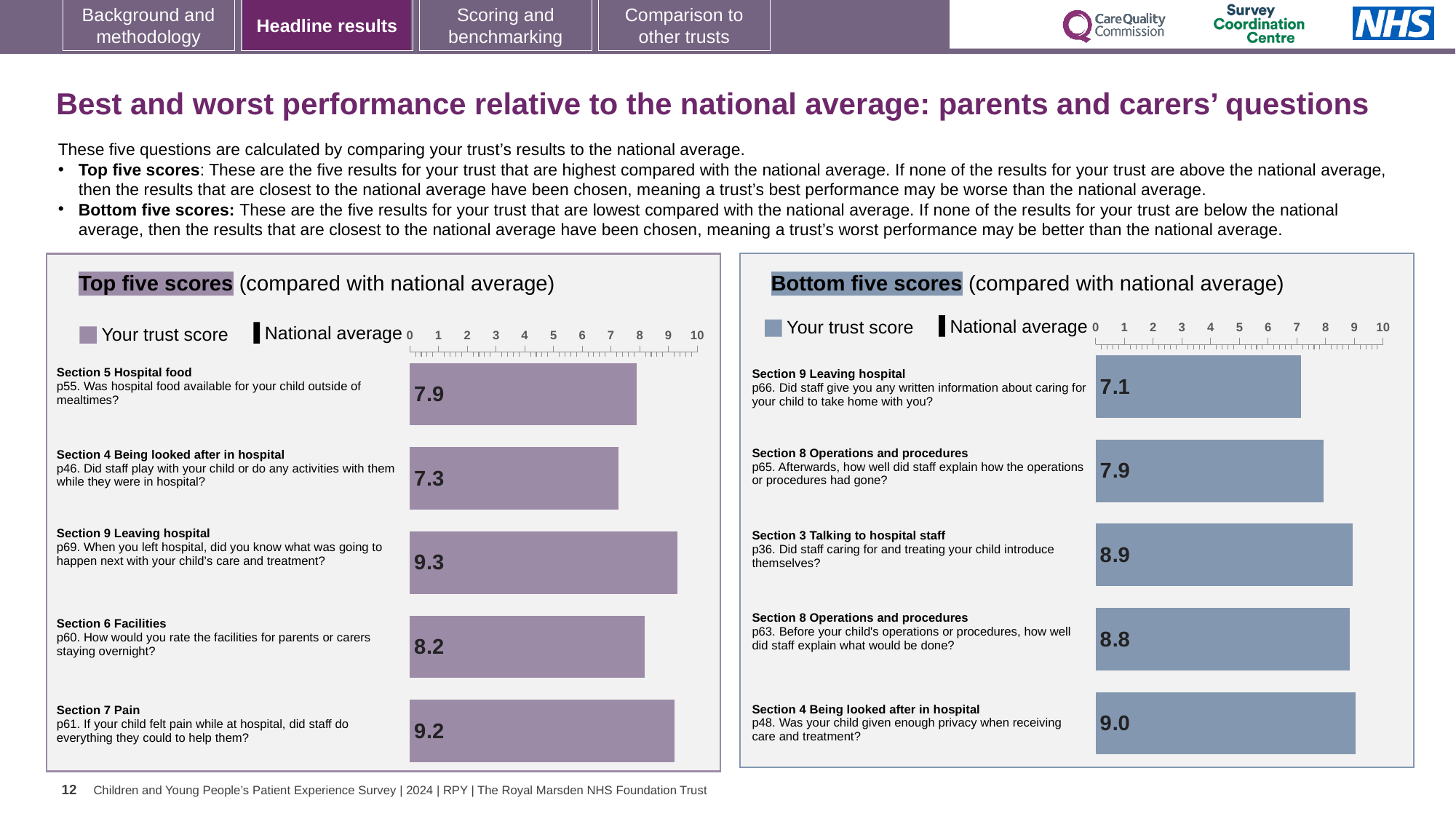
What kind of chart is the Bottom five scores chart? Bar chart In the Top five scores chart, which question has the lowest trust score? p46 (Section 4 Being looked after in hospital) How many entries does the legend of the Top five scores chart list? 2 In the Top five scores chart, what is the trust score for p61 (If your child felt pain while at hospital, did staff do everything they could to help them?)? 9.2 In the Bottom five scores chart, which question has the lowest trust score? p66 (Section 9 Leaving hospital) In the Bottom five scores chart, which has the larger trust score: p36 or p65? p36 In the Top five scores chart, what is the trust score for p55 (Was hospital food available for your child outside of mealtimes?)? 7.9 How many questions are plotted in the Top five scores chart? 5 In the Bottom five scores chart, which question has the highest trust score? p48 (Section 4 Being looked after in hospital) In the Top five scores chart, which question has the highest trust score? p69 (Section 9 Leaving hospital) In the Bottom five scores chart, what is the trust score for p66 (Did staff give you any written information about caring for your child to take home with you?)? 7.1 In the Top five scores chart, what is the difference between the trust scores for p69 and p46? 2.0